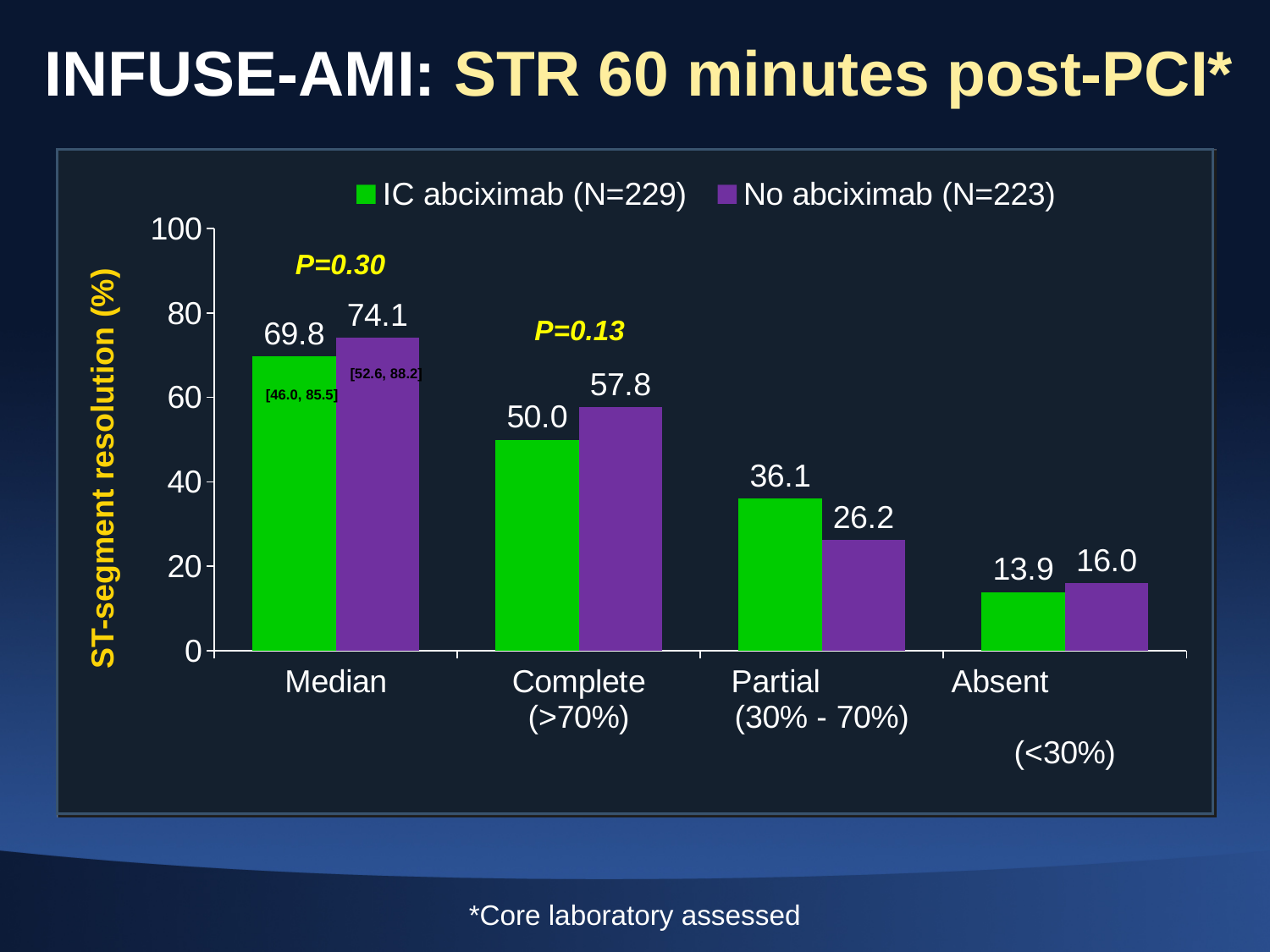
What is the value for No abciximab in the Complete (>70%) category? 57.8 What is the value for IC abciximab in the Partial (30% - 70%) category? 36.1 How many series does the legend list? 2 In the Complete (>70%) category, which series has the larger value? No abciximab What is the value for IC abciximab in the Median category? 69.8 What is the value for No abciximab in the Absent (<30%) category? 16.0 Which category has the highest value for the No abciximab series? Median What P value is shown above the Median bars? P=0.30 What is the difference between the No abciximab and IC abciximab values in the Partial (30% - 70%) category? 9.9 How many categories are shown on the x axis? 4 Which category has the lowest value for the IC abciximab series? Absent (<30%) What kind of chart is shown on the slide? Bar chart